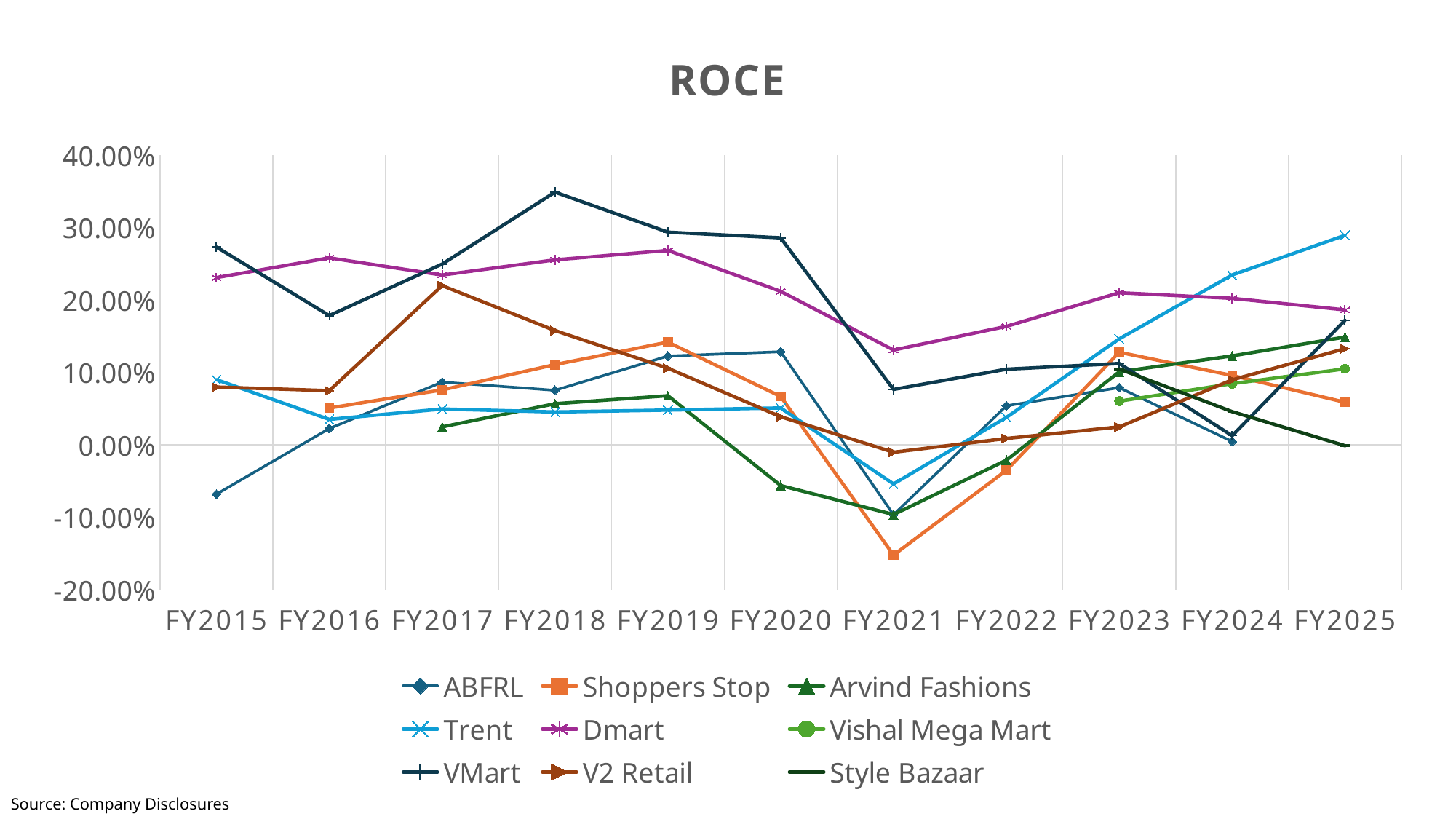
In FY2025, which is higher, Trent or Dmart? Trent Does the Trent line rise or fall from FY2021 to FY2025? rise Which series has the highest ROCE in FY2018? VMart How many series does the legend list? 9 Is the value for Shoppers Stop in FY2021 greater or less than -10.00%? less Which series has the lowest ROCE in FY2021? Shoppers Stop Is the value for Vishal Mega Mart in FY2023 greater or less than 10.00%? less How many fiscal years are shown on the x axis? 11 Is the value for ABFRL in FY2015 greater or less than 0.00%? less What is the title of the chart? ROCE What kind of chart is shown on the slide? line chart